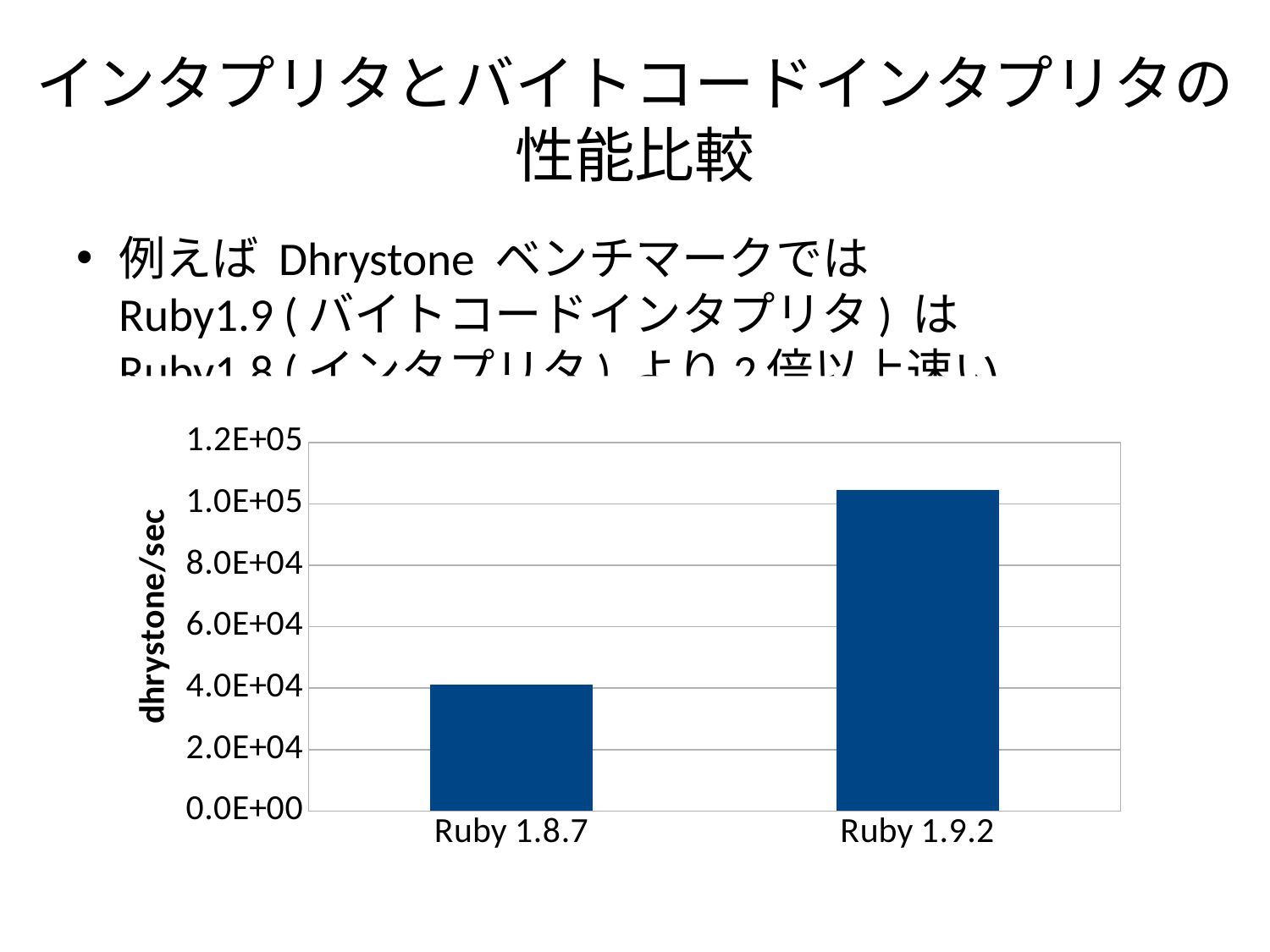
What kind of chart is shown on the slide? bar chart Is the value for Ruby 1.9.2 greater or less than 1.2E+05? less How many categories are plotted in the chart? 2 Which category has the lowest value in the chart? Ruby 1.8.7 Which category has the highest value in the chart? Ruby 1.9.2 Which has a larger value, Ruby 1.8.7 or Ruby 1.9.2? Ruby 1.9.2 Is the value for Ruby 1.8.7 greater or less than 6.0E+04? less What colour are the bars in the chart? dark blue What is the label on the vertical axis of the chart? dhrystone/sec Is the value for Ruby 1.9.2 greater or less than 8.0E+04? greater